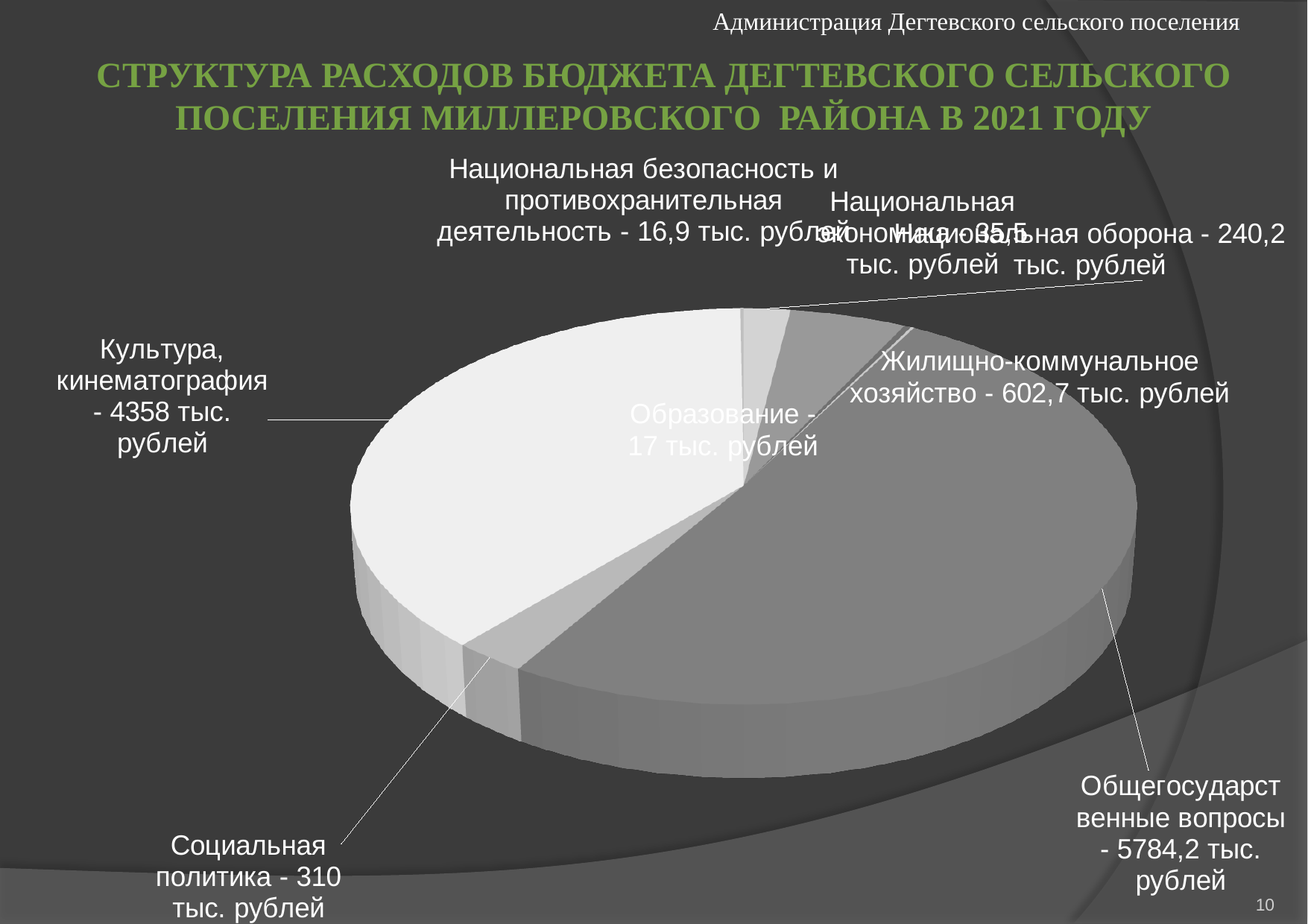
What is the value for Образование? 17 тыс. рублей How many expenditure categories are shown in the pie chart? 8 Which expenditure category has the largest value? Общегосударственные вопросы What is the value for Общегосударственные вопросы? 5784,2 тыс. рублей Which is larger: Жилищно-коммунальное хозяйство or Социальная политика? Жилищно-коммунальное хозяйство What is the value for Жилищно-коммунальное хозяйство? 602,7 тыс. рублей What kind of chart is shown on the slide? Pie chart What is the difference between Общегосударственные вопросы and Культура, кинематография? 1426,2 тыс. рублей What is the value for Культура, кинематография? 4358 тыс. рублей What is the value for Национальная оборона? 240,2 тыс. рублей Which expenditure category has the smallest value? Национальная безопасность и противохранительная деятельность What is the value for Социальная политика? 310 тыс. рублей